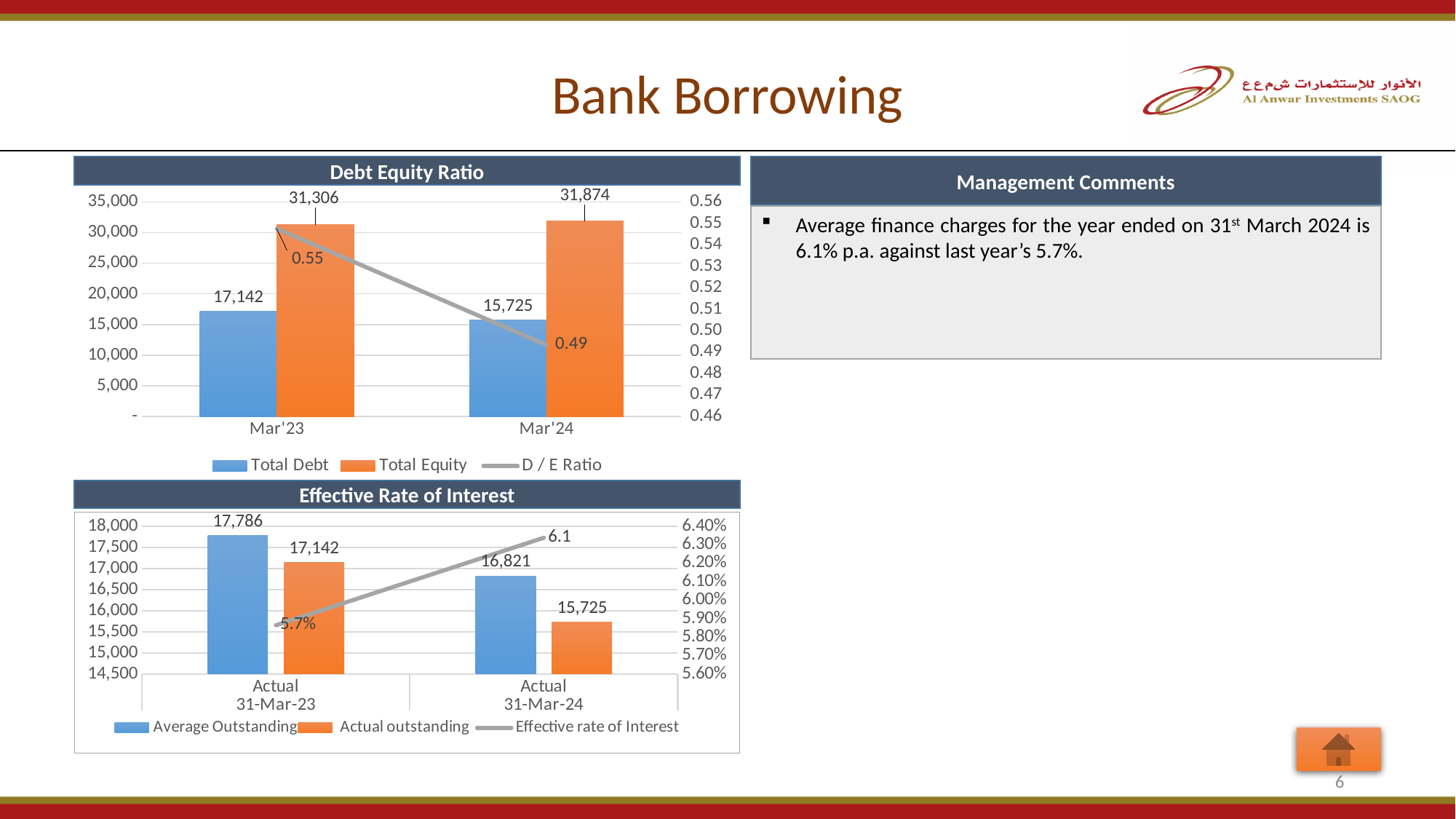
In the Debt Equity Ratio chart, what is the Total Debt for Mar'23? 17,142 In the Debt Equity Ratio chart, does the D / E Ratio rise or fall from Mar'23 to Mar'24? fall What kind of chart is the Effective Rate of Interest chart? Bar chart with a line How many series does the legend of the Debt Equity Ratio chart list? 3 In the Effective Rate of Interest chart, which is larger for Actual 31-Mar-24: Average Outstanding or Actual outstanding? Average Outstanding In the Effective Rate of Interest chart, what is the Effective rate of Interest for Actual 31-Mar-23? 5.7% In the Effective Rate of Interest chart, what is the Average Outstanding for Actual 31-Mar-23? 17,786 In the Effective Rate of Interest chart, what is the difference between Average Outstanding and Actual outstanding for Actual 31-Mar-23? 644 In the Effective Rate of Interest chart, what is the Actual outstanding for Actual 31-Mar-24? 15,725 In the Debt Equity Ratio chart, what is the difference between Total Equity in Mar'24 and Mar'23? 568 In the Debt Equity Ratio chart, what is the D / E Ratio for Mar'24? 0.49 In the Debt Equity Ratio chart, what is the Total Equity for Mar'24? 31,874